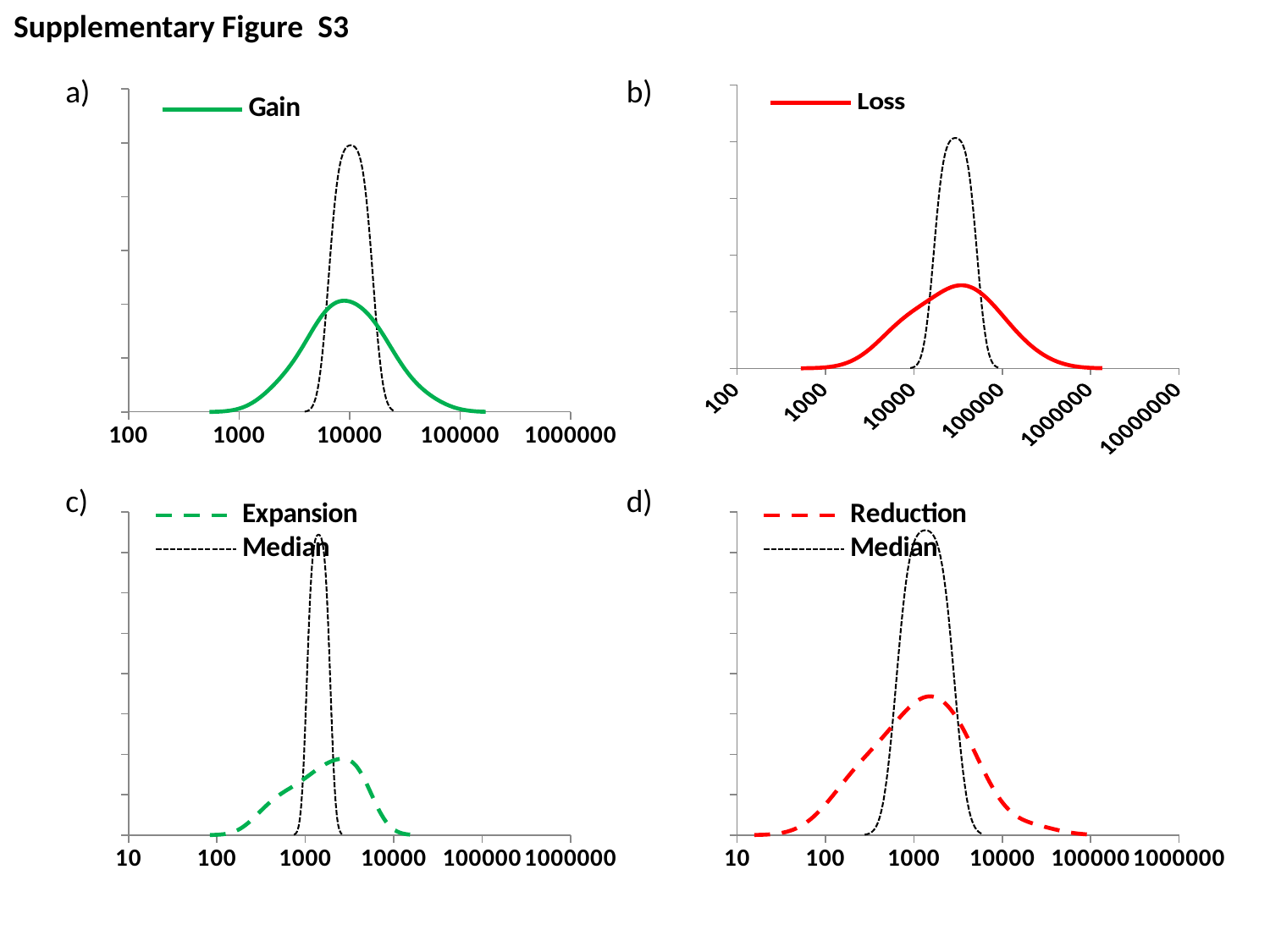
In panel a), is the x-axis position of the Gain curve's peak greater or less than 100000? less In panel d), which curve reaches a higher peak, Reduction or Median? Median What kind of chart is panel a)? line chart How many series does the legend in panel a) list? 1 In panel b), is the x-axis position of the Loss curve's peak greater or less than 10000? greater In panel d), does the Reduction curve rise or fall as x increases from 1000 to 10000? fall How many charts are shown on the slide? 4 In panel a), which curve reaches a higher peak, the Gain curve or the dashed median curve? the dashed median curve In panel c), is the x-axis position of the Expansion curve's peak greater or less than 1000? greater What colour is the Gain line in panel a)? green What is the name of the series shown in the legend of panel b)? Loss How many series does the legend in panel c) list? 2